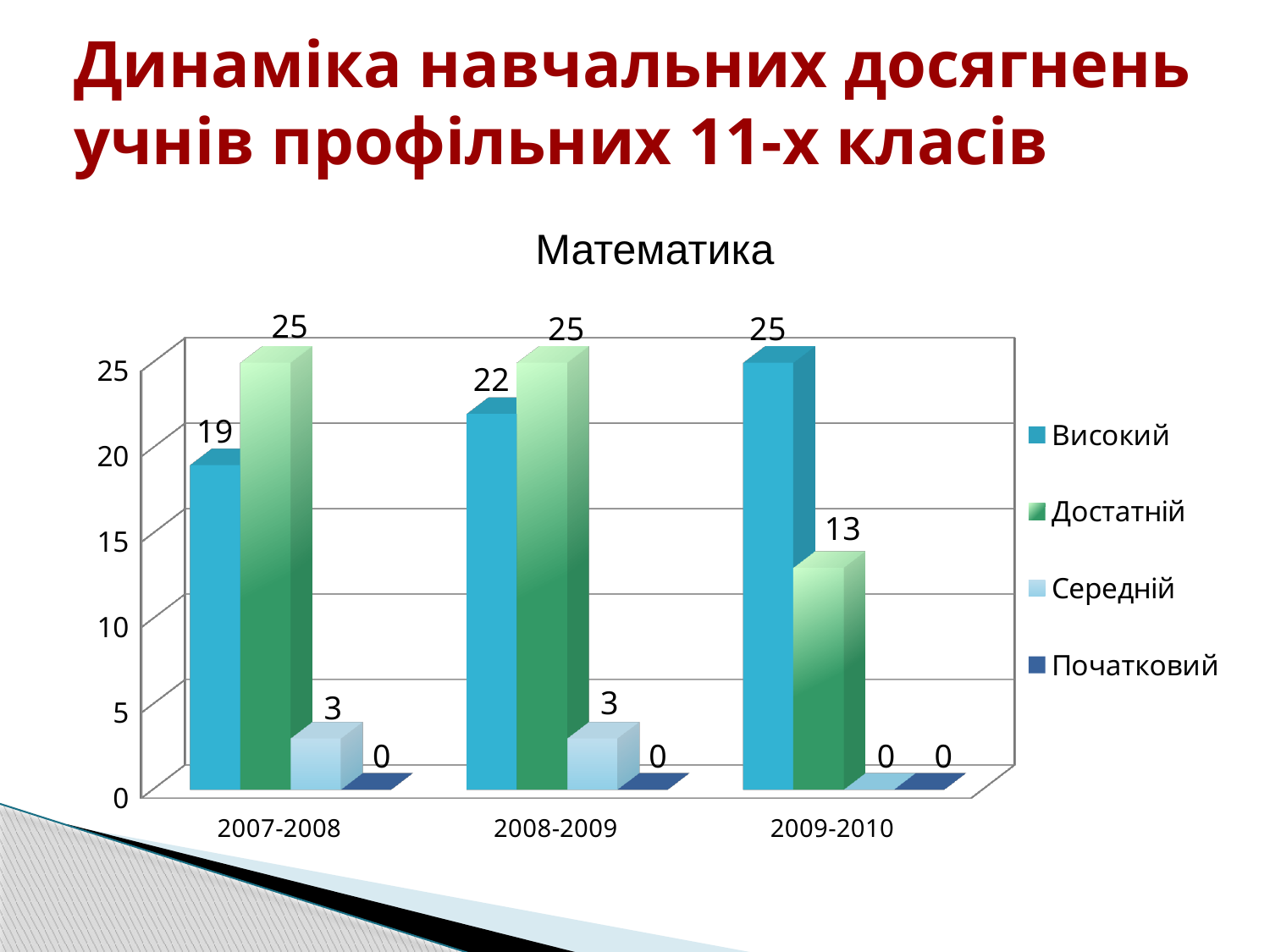
What is the value for Початковий in 2009-2010? 0 What is the value for Середній in 2008-2009? 3 In which school year is the value for Високий the highest? 2009-2010 What is the title of the chart? Математика Which is larger in 2008-2009, Високий or Достатній? Достатній What is the value for Високий in 2007-2008? 19 What kind of chart is shown on the slide? bar chart What is the value for Достатній in 2009-2010? 13 What is the difference between Достатній and Високий in 2007-2008? 6 How many school years are shown on the x axis? 3 How many series does the legend list? 4 In which school year is the value for Достатній the lowest? 2009-2010